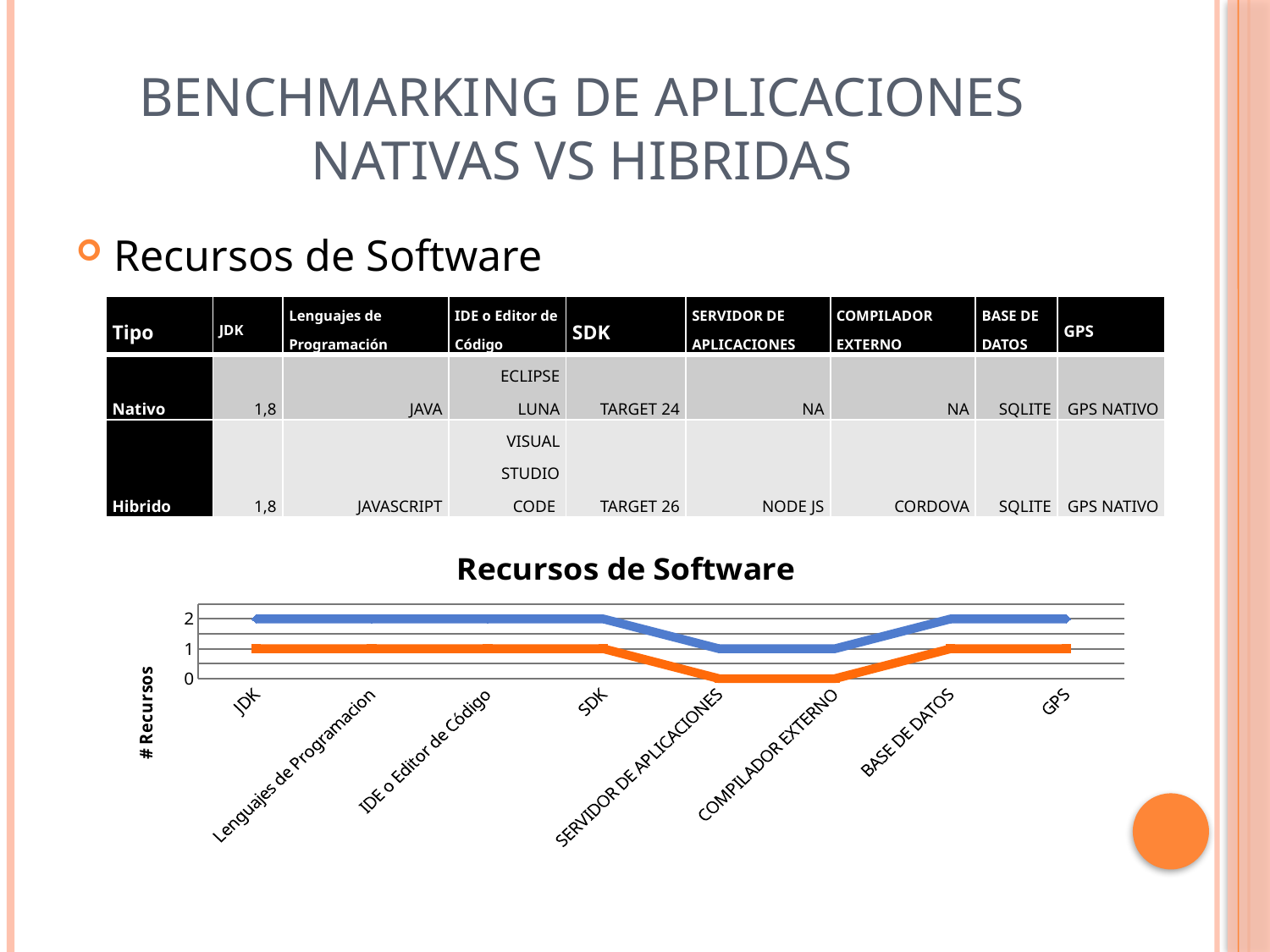
In the 'Recursos de Software' chart, what is the difference between the blue line and the orange line at SDK? 1 In the 'Recursos de Software' chart, what is the value of the orange line at GPS? 1 In the 'Recursos de Software' chart, does the blue line rise or fall from SDK to SERVIDOR DE APLICACIONES? fall What kind of chart is shown under the table on the slide? line chart In the 'Recursos de Software' chart, what is the value of the orange line at SERVIDOR DE APLICACIONES? 0 In the 'Recursos de Software' chart, at which categories does the orange line reach its lowest value of 0? SERVIDOR DE APLICACIONES and COMPILADOR EXTERNO In the 'Recursos de Software' chart, what is the value of the blue line at JDK? 2 How many categories are shown on the x axis of the 'Recursos de Software' chart? 8 What is the label of the vertical axis of the 'Recursos de Software' chart? # Recursos In the 'Recursos de Software' chart, what is the value of the blue line at COMPILADOR EXTERNO? 1 In the 'Recursos de Software' chart, which line has the higher value at BASE DE DATOS, the blue line or the orange line? the blue line What is the title of the chart on the slide? Recursos de Software